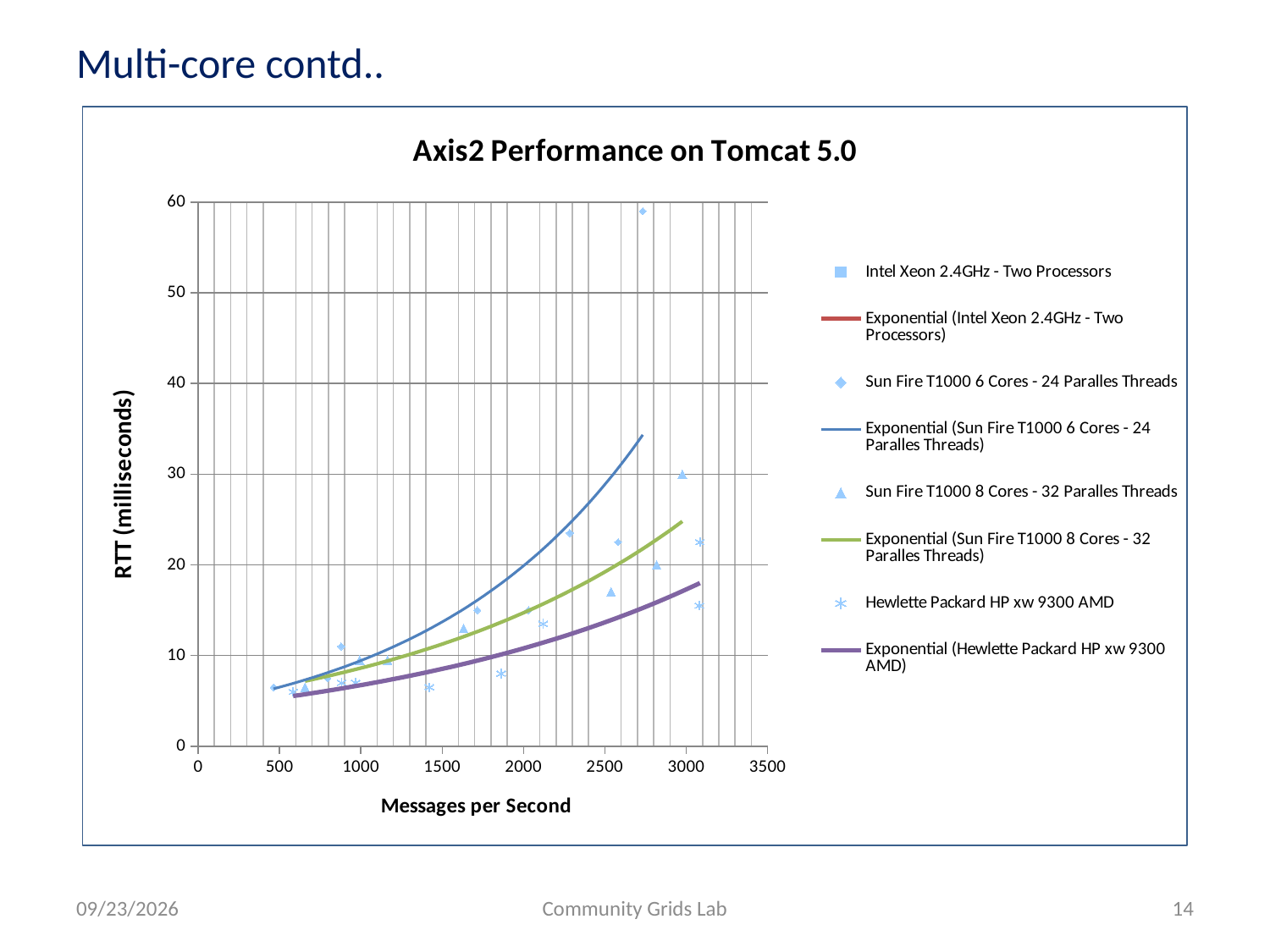
What kind of chart is shown on the slide? scatter chart As messages per second increase along the x axis, do the RTT values generally rise or fall? rise What is the label of the vertical axis? RTT (milliseconds) Is the highest plotted point for Sun Fire T1000 6 Cores - 24 Paralles Threads greater or less than 50 milliseconds? greater Which series has the highest plotted point on the chart? Sun Fire T1000 6 Cores - 24 Paralles Threads What is the title of the chart? Axis2 Performance on Tomcat 5.0 Is the Hewlette Packard HP xw 9300 AMD point near 1400 messages per second greater or less than 10 milliseconds? less How many exponential trendlines does the legend list? 4 Near 3000 messages per second, which trendline is higher: Exponential (Sun Fire T1000 6 Cores - 24 Paralles Threads) or Exponential (Hewlette Packard HP xw 9300 AMD)? Exponential (Sun Fire T1000 6 Cores - 24 Paralles Threads) How many entries does the chart legend list? 8 Is the Sun Fire T1000 8 Cores - 32 Paralles Threads point near 3000 messages per second greater or less than 20 milliseconds? greater Which exponential trendline is the lowest across the plotted range? Exponential (Hewlette Packard HP xw 9300 AMD)